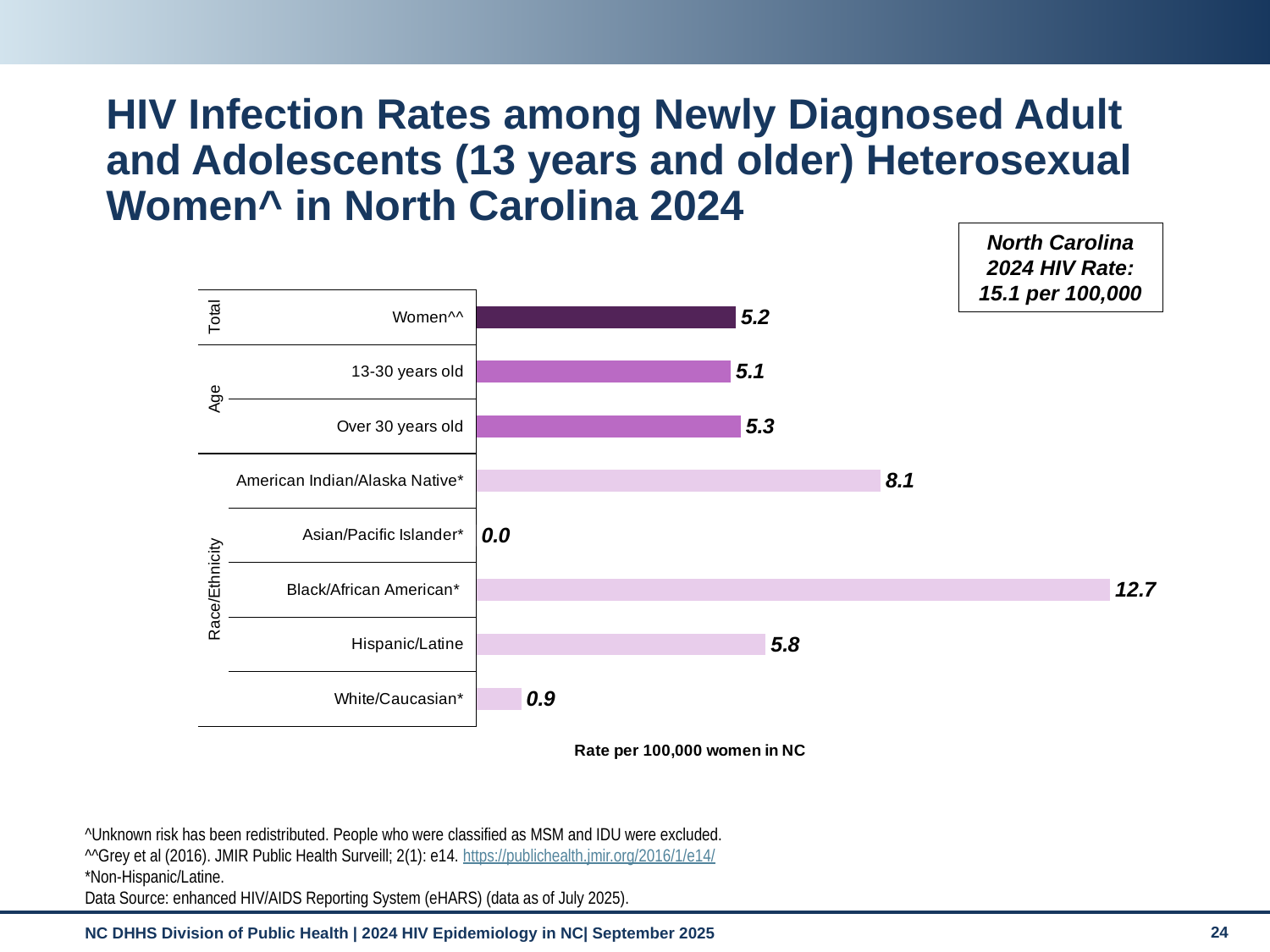
Which category has the lowest rate on the chart? Asian/Pacific Islander* Which has a higher rate: American Indian/Alaska Native* or Hispanic/Latine? American Indian/Alaska Native* What is the North Carolina 2024 HIV rate stated in the box on the slide? 15.1 per 100,000 What type of chart is shown on the slide? Bar chart What is the rate for Hispanic/Latine heterosexual women? 5.8 What is the HIV infection rate for Black/African American* heterosexual women? 12.7 What is the difference between the rates for Over 30 years old and 13-30 years old? 0.2 What is the rate for heterosexual women aged 13-30 years old? 5.1 How many categories (bars) are shown on the chart? 8 What is the difference between the rates for Black/African American* and White/Caucasian* women? 11.8 Which race/ethnicity category has the highest rate? Black/African American* What is the rate shown for the Women^^ total bar? 5.2